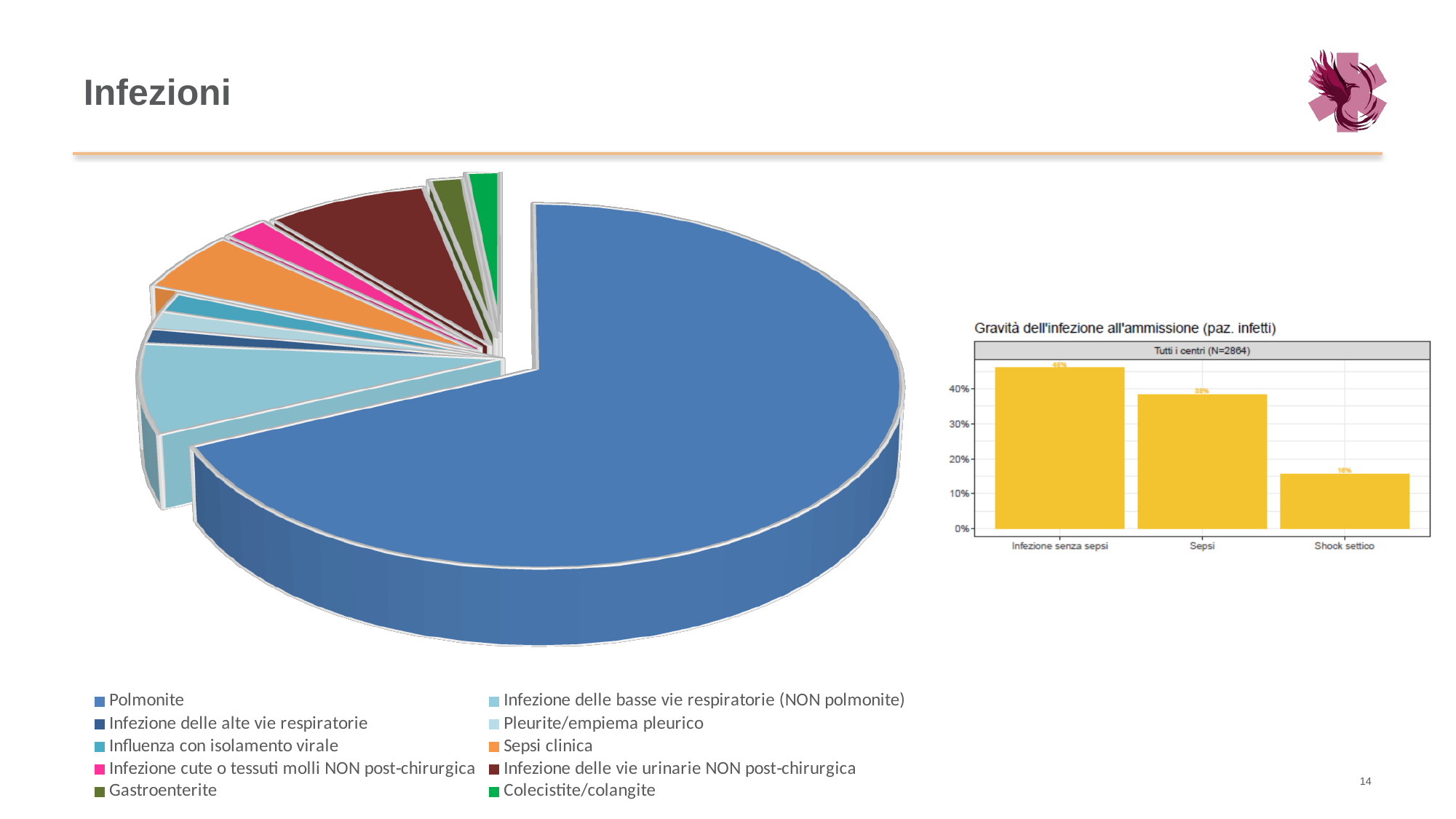
In the chart 'Gravità dell'infezione all'ammissione (paz. infetti)', which category has the highest value? Infezione senza sepsi In the chart 'Gravità dell'infezione all'ammissione (paz. infetti)', which category has the lowest value? Shock settico In the pie chart on the left, how many categories does the legend list? 10 In the chart 'Gravità dell'infezione all'ammissione (paz. infetti)', how many bars are there? 3 What is the title of the bar chart on the right of the slide? Gravità dell'infezione all'ammissione (paz. infetti) In the pie chart on the left, which is larger: the slice for Polmonite or the slice for Sepsi clinica? Polmonite In the pie chart on the left, which category has the largest slice? Polmonite In the chart 'Gravità dell'infezione all'ammissione (paz. infetti)', do the values rise or fall from left to right along the x axis? fall In the chart 'Gravità dell'infezione all'ammissione (paz. infetti)', is the value for Infezione senza sepsi greater or less than 40%? greater In the chart 'Gravità dell'infezione all'ammissione (paz. infetti)', is the value for Shock settico greater or less than 20%? less What kind of chart is the chart titled 'Gravità dell'infezione all'ammissione (paz. infetti)'? bar chart What kind of chart is the chart on the left of the slide? pie chart